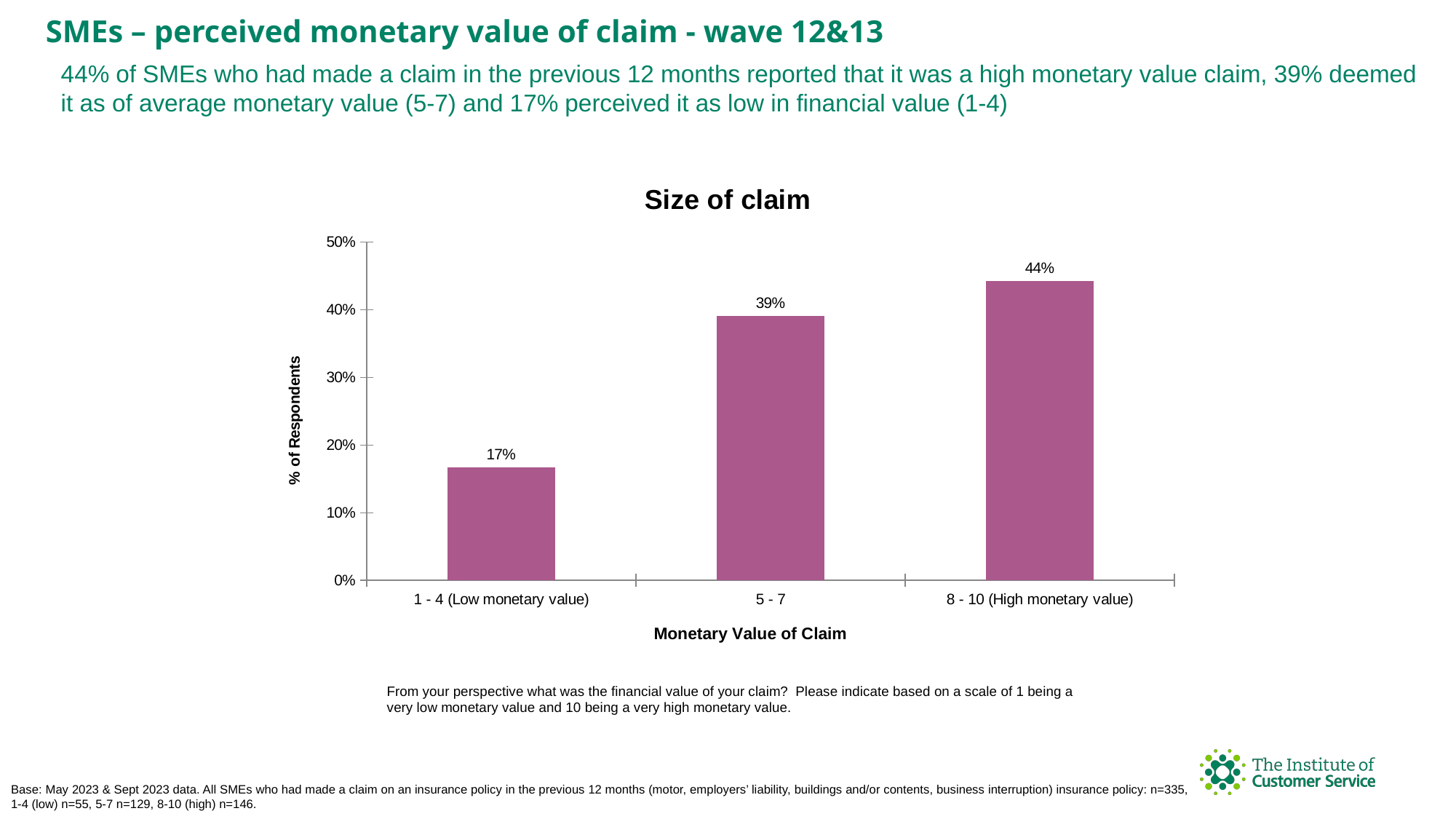
Which category has the highest percentage of respondents? 8 - 10 (High monetary value) Is the value for 5 - 7 greater or less than 30%? greater What percentage of respondents is shown for the 1 - 4 (Low monetary value) category? 17% How many categories are shown on the x axis of the chart? 3 What percentage of respondents is shown for the 5 - 7 category? 39% Which category has the lowest percentage of respondents? 1 - 4 (Low monetary value) What kind of chart is shown on the slide? Bar chart Which is larger, the value for 5 - 7 or the value for 8 - 10 (High monetary value)? 8 - 10 (High monetary value) What percentage of respondents is shown for the 8 - 10 (High monetary value) category? 44% What is the difference in percentage points between the 8 - 10 (High monetary value) and 1 - 4 (Low monetary value) categories? 27 percentage points What is the title of the chart? Size of claim Do the values rise or fall moving from left to right along the x axis? Rise